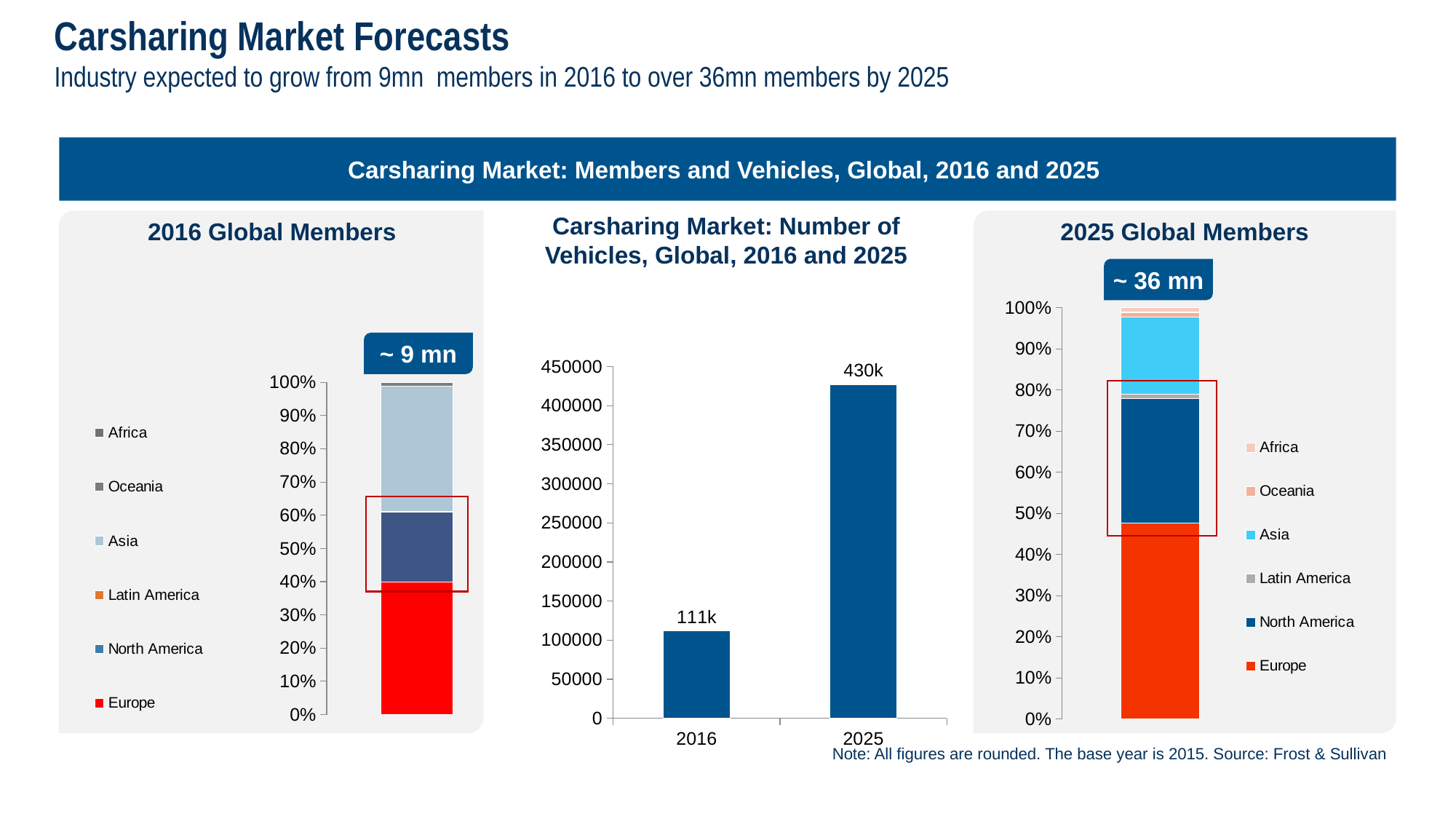
In the Carsharing Market: Number of Vehicles chart, do the values rise or fall from 2016 to 2025? rise What total number of members is annotated above the bar in the 2025 Global Members chart? ~ 36 mn In the Carsharing Market: Number of Vehicles chart, which year has the larger value, 2016 or 2025? 2025 In the Carsharing Market: Number of Vehicles chart, is the value for 2016 greater or less than 150000? less In the Carsharing Market: Number of Vehicles chart, how many years are plotted? 2 In the 2025 Global Members chart, is the share for Asia greater or less than 20%? less In the 2016 Global Members chart, is the share for Europe greater or less than 50%? less What kind of chart is the Carsharing Market: Number of Vehicles chart? bar chart In the 2025 Global Members chart, which region has the largest share of the bar? Europe How many series does the legend of the 2016 Global Members chart list? 6 In the Carsharing Market: Number of Vehicles chart, what is the value for 2016? 111k In the Carsharing Market: Number of Vehicles chart, what is the value for 2025? 430k